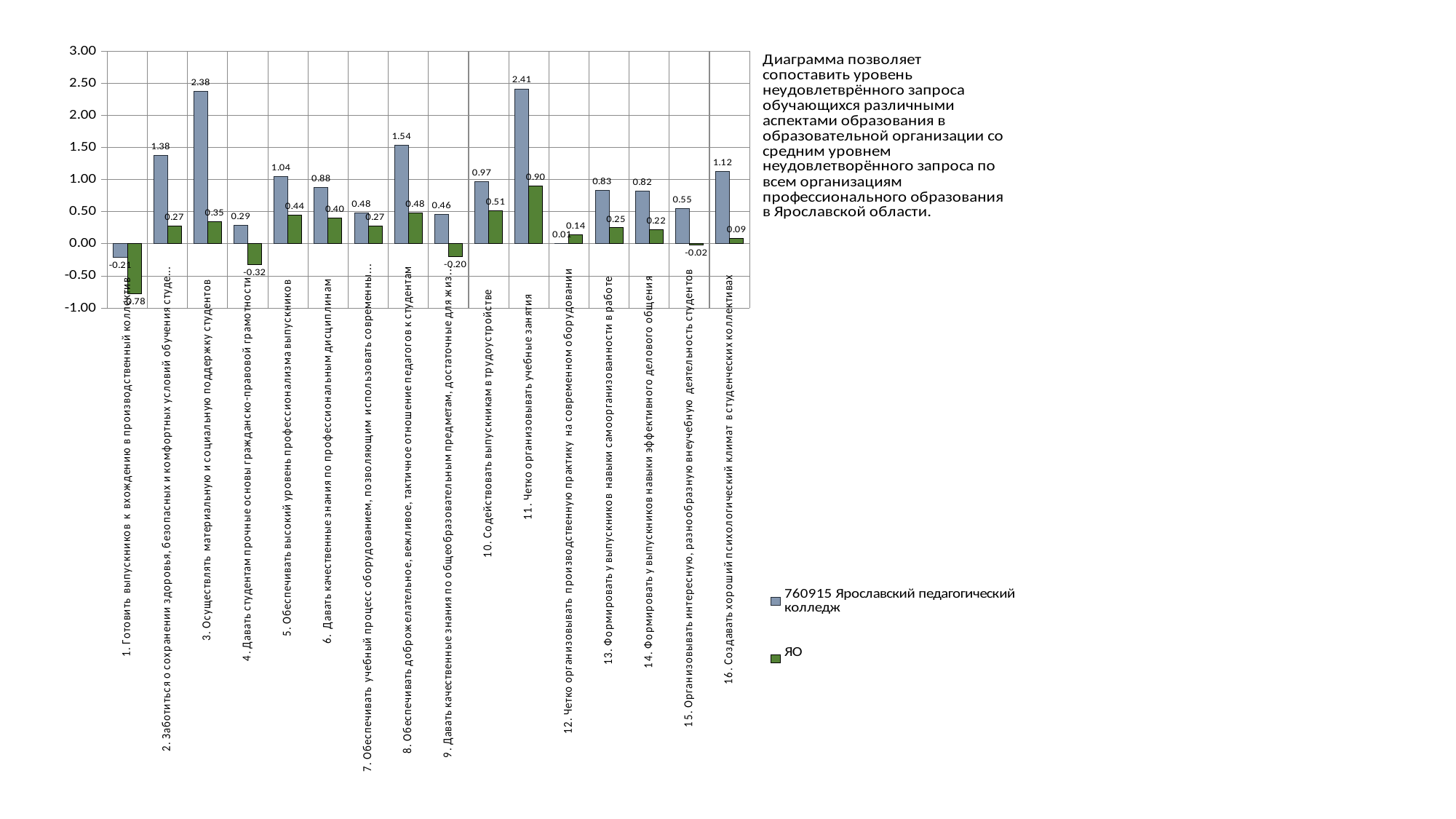
What is the value for 'ЯО' in category '3. Осуществлять материальную и социальную поддержку студентов'? 0.35 What is the value for '760915 Ярославский педагогический колледж' in category '8. Обеспечивать доброжелательное, вежливое, тактичное отношение педагогов к студентам'? 1.54 In category '12. Четко организовывать производственную практику на современном оборудовании', which series has the larger value? ЯО What colour are the bars for the 'ЯО' series? green How many categories are shown on the x axis? 16 Which category has the highest value for the 'ЯО' series? 11. Четко организовывать учебные занятия What is the difference between the '760915 Ярославский педагогический колледж' and 'ЯО' values in category '2. Заботиться о сохранении здоровья, безопасных и комфортных условий обучения студентов'? 1.11 Is the value for '760915 Ярославский педагогический колледж' in category '16. Создавать хороший психологический климат в студенческих коллективах' greater or less than 1.00? greater How many series does the legend list? 2 What type of chart is shown on the slide? bar chart Which category has the lowest value for the 'ЯО' series? 1. Готовить выпускников к вхождению в производственный коллектив What is the value for '760915 Ярославский педагогический колледж' in category '11. Четко организовывать учебные занятия'? 2.41